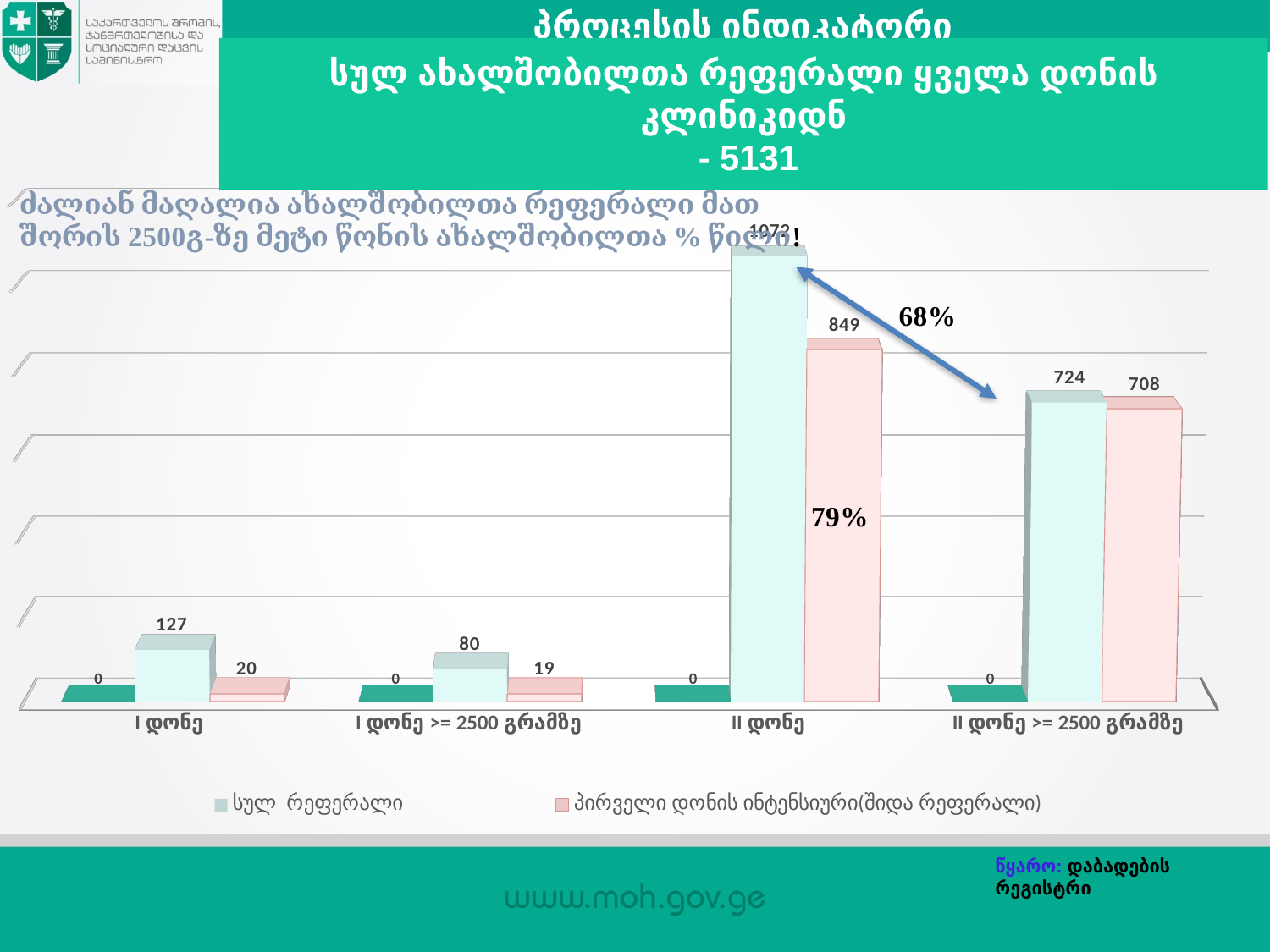
Which category has the highest value for სულ რეფერალი? II დონე What is the value of პირველი დონის ინტენსიური(შიდა რეფერალი) for II დონე? 849 Which category has the lowest value for სულ რეფერალი? I დონე >= 2500 გრამზე For I დონე, which is larger: სულ რეფერალი or პირველი დონის ინტენსიური(შიდა რეფერალი)? სულ რეფერალი What is the value of სულ რეფერალი for I დონე >= 2500 გრამზე? 80 What kind of chart is shown on the slide? bar chart What is the value of სულ რეფერალი for II დონე >= 2500 გრამზე? 724 What is the value of სულ რეფერალი for I დონე? 127 How many categories are shown on the x axis of the chart? 4 How many series does the legend list? 2 What is the value of პირველი დონის ინტენსიური(შიდა რეფერალი) for II დონე >= 2500 გრამზე? 708 What is the difference between სულ რეფერალი and პირველი დონის ინტენსიური(შიდა რეფერალი) for II დონე >= 2500 გრამზე? 16